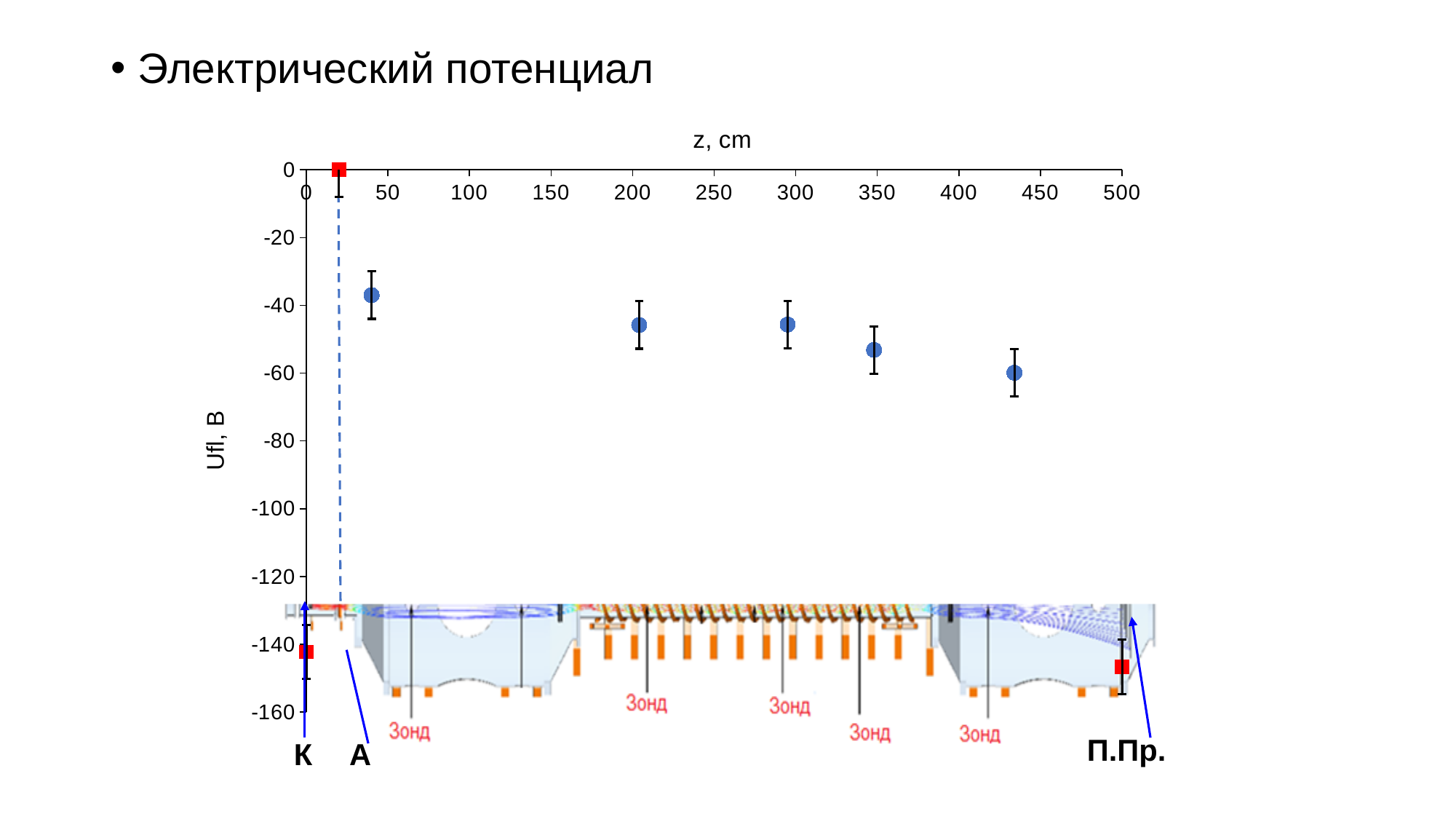
Do the values of the blue points rise or fall as z increases along the x axis? fall What is the title of the horizontal axis? z, cm Which blue point has the larger value: the one near z = 40 cm or the one near z = 435 cm? the one near z = 40 cm Is the value of the red square near z = 500 cm greater or less than -140? less Is the value of the blue point near z = 435 cm greater or less than -40? less Is the value of the blue point near z = 350 cm greater or less than -60? greater What kind of chart is shown on the slide? scatter chart How many blue circular data points are plotted on the chart? 5 How many red square markers are plotted on the chart? 3 What is the title of the vertical axis? Ufl, B